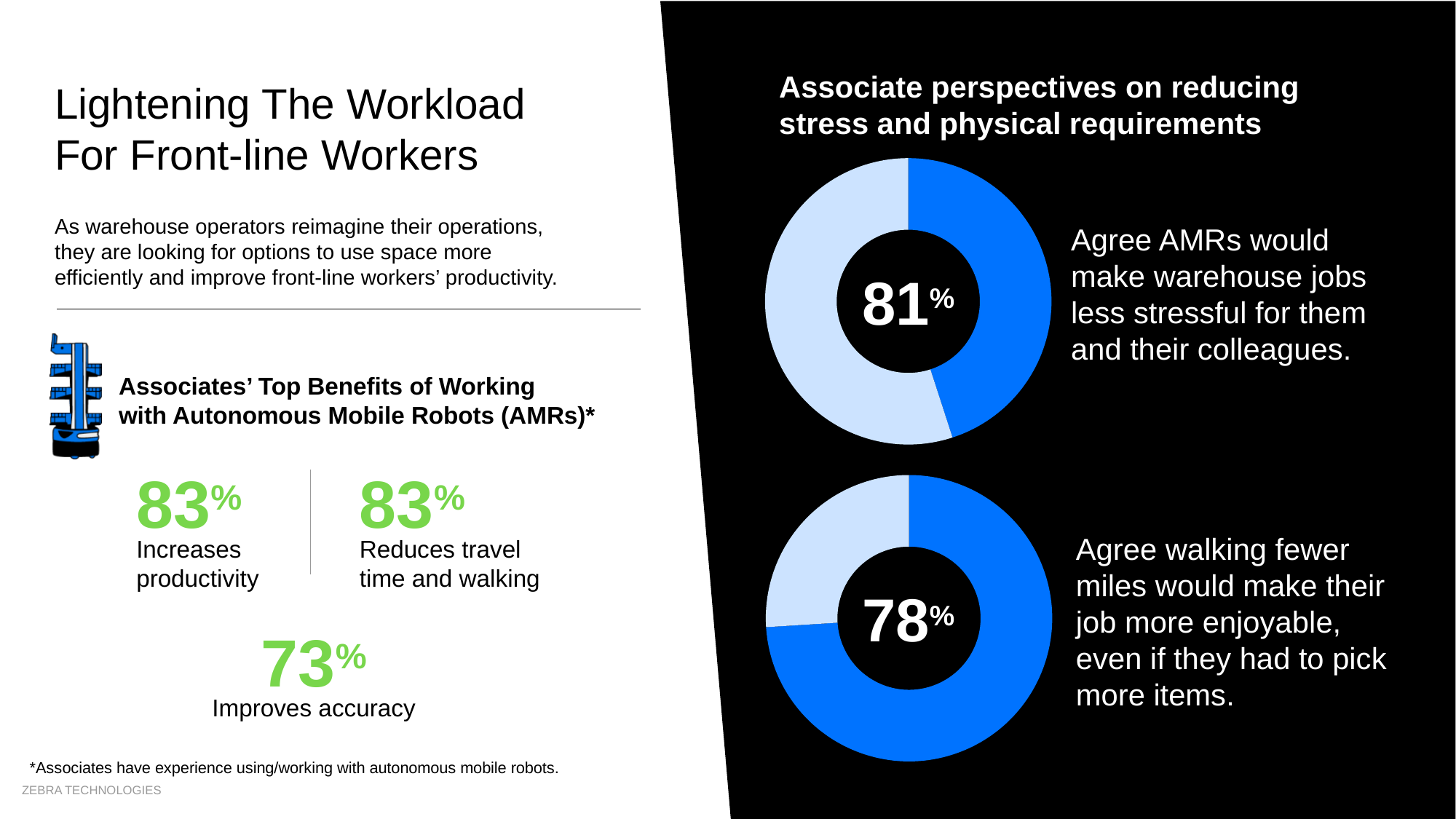
What kind of chart is used on the right side of the slide to show the associate perspectives? donut chart What is the heading above the two donut charts? Associate perspectives on reducing stress and physical requirements Which donut chart shows the larger percentage, the top one (less stressful) or the bottom one (more enjoyable)? the top one (81%) In the bottom donut chart, what percentage of associates agree walking fewer miles would make their job more enjoyable, even if they had to pick more items? 78% Which statement has the highest level of agreement among the two donut charts? Agree AMRs would make warehouse jobs less stressful for them and their colleagues What two colours are used for the segments of the donut charts? dark blue and light blue What is the difference between the percentage in the top donut chart and the percentage in the bottom donut chart? 3% Which statement has the lowest level of agreement among the two donut charts? Agree walking fewer miles would make their job more enjoyable, even if they had to pick more items What value is printed in the centre of the bottom donut chart? 78% How many donut charts are shown on the slide? 2 What value is printed in the centre of the top donut chart? 81% In the top donut chart, what percentage of associates agree AMRs would make warehouse jobs less stressful for them and their colleagues? 81%